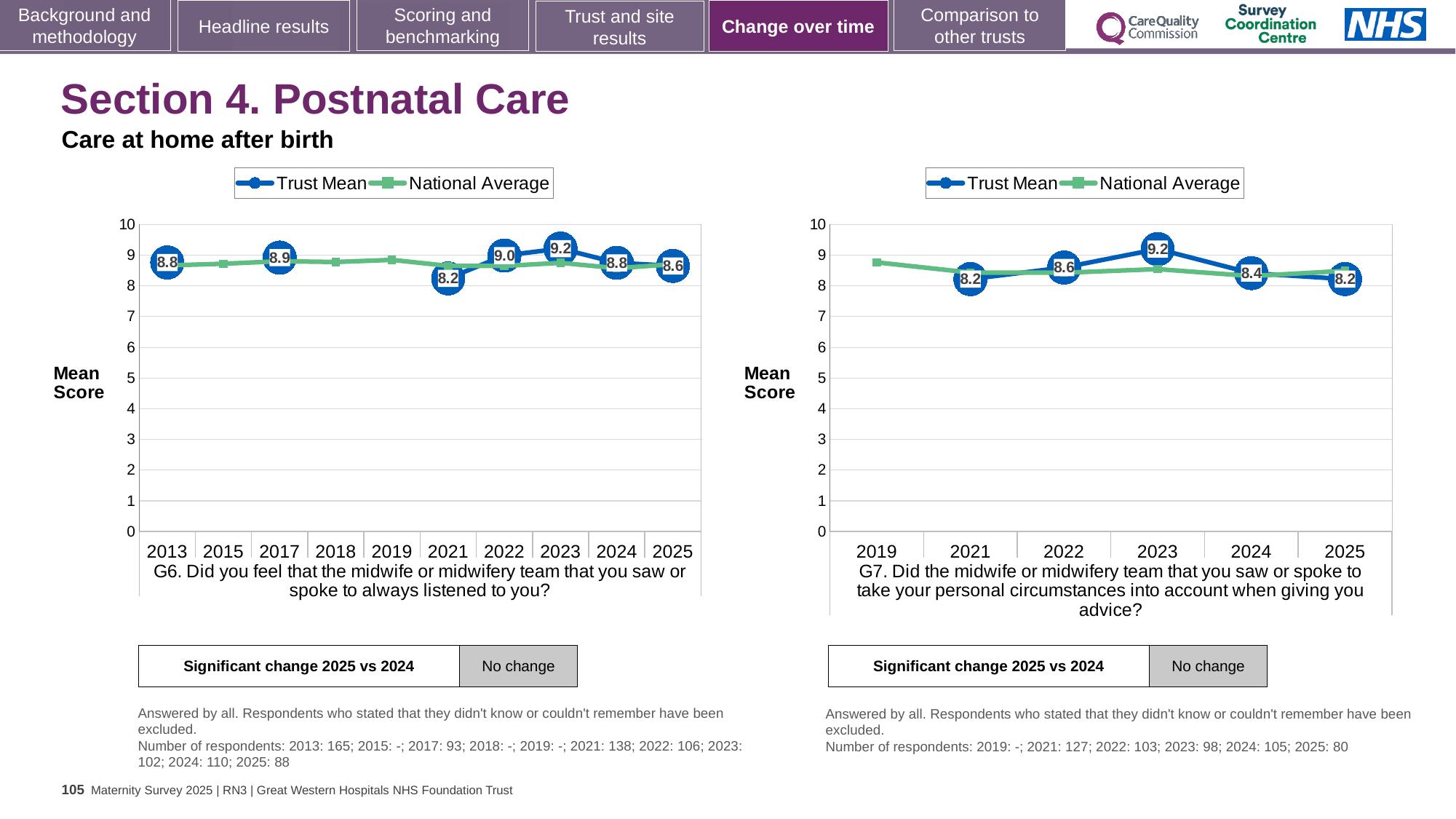
What type of chart is the left chart (G6)? line chart In the left chart (G6), what is the difference between the Trust Mean in 2023 and in 2025? 0.6 In the right chart (G7), does the Trust Mean rise or fall from 2023 to 2025? fall In the right chart (G7), what is the Trust Mean for 2024? 8.4 In the left chart (G6), what is the Trust Mean for 2021? 8.2 How many series does the legend of the right chart (G7) list? 2 In the right chart (G7), is the Trust Mean higher in 2022 or in 2025? 2022 In the left chart (G6), how many years are shown on the x axis? 10 In the left chart (G6), which year has the highest Trust Mean? 2023 In the left chart (G6), which year has the lowest Trust Mean? 2021 In the left chart (G6), what is the Trust Mean for 2023? 9.2 In the right chart (G7), which year has the highest Trust Mean? 2023